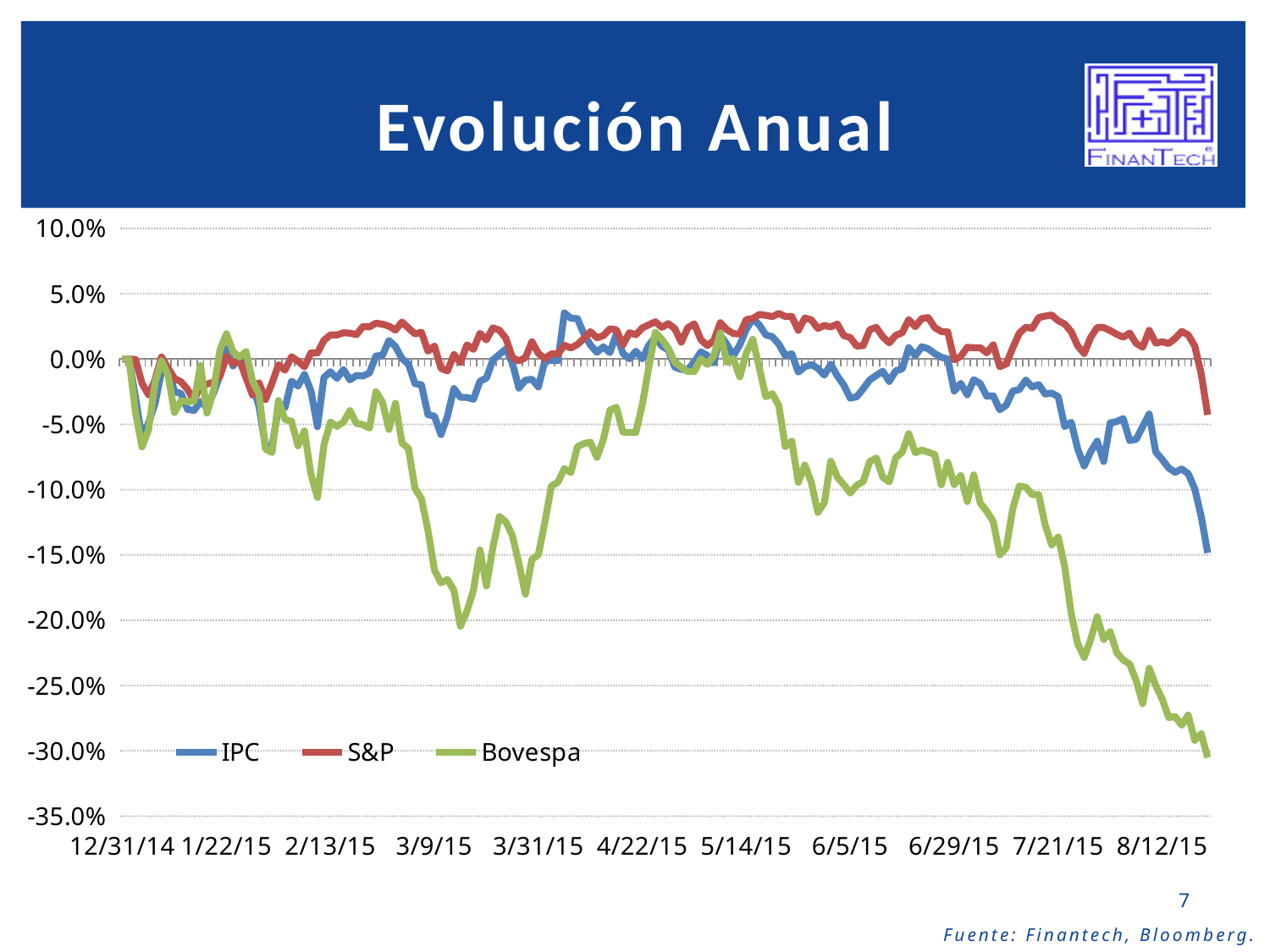
Is the lowest point of the Bovespa line around 3/9/15 greater or less than -15.0%? less How many series does the legend list? 3 Does the Bovespa line rise or fall overall from 6/29/15 to the right end of the chart? fall What is the title of the chart? Evolución Anual Is the value of IPC at the right end of the chart greater or less than -10.0%? less Which series has the lowest value at the right end of the chart? Bovespa What kind of chart is shown on the slide? line chart What are the three series named in the legend? IPC, S&P, Bovespa Is the value of Bovespa at the right end of the chart greater or less than -25.0%? less At the right end of the chart, which is larger, the IPC value or the Bovespa value? IPC Which series has the highest value at the right end of the chart? S&P